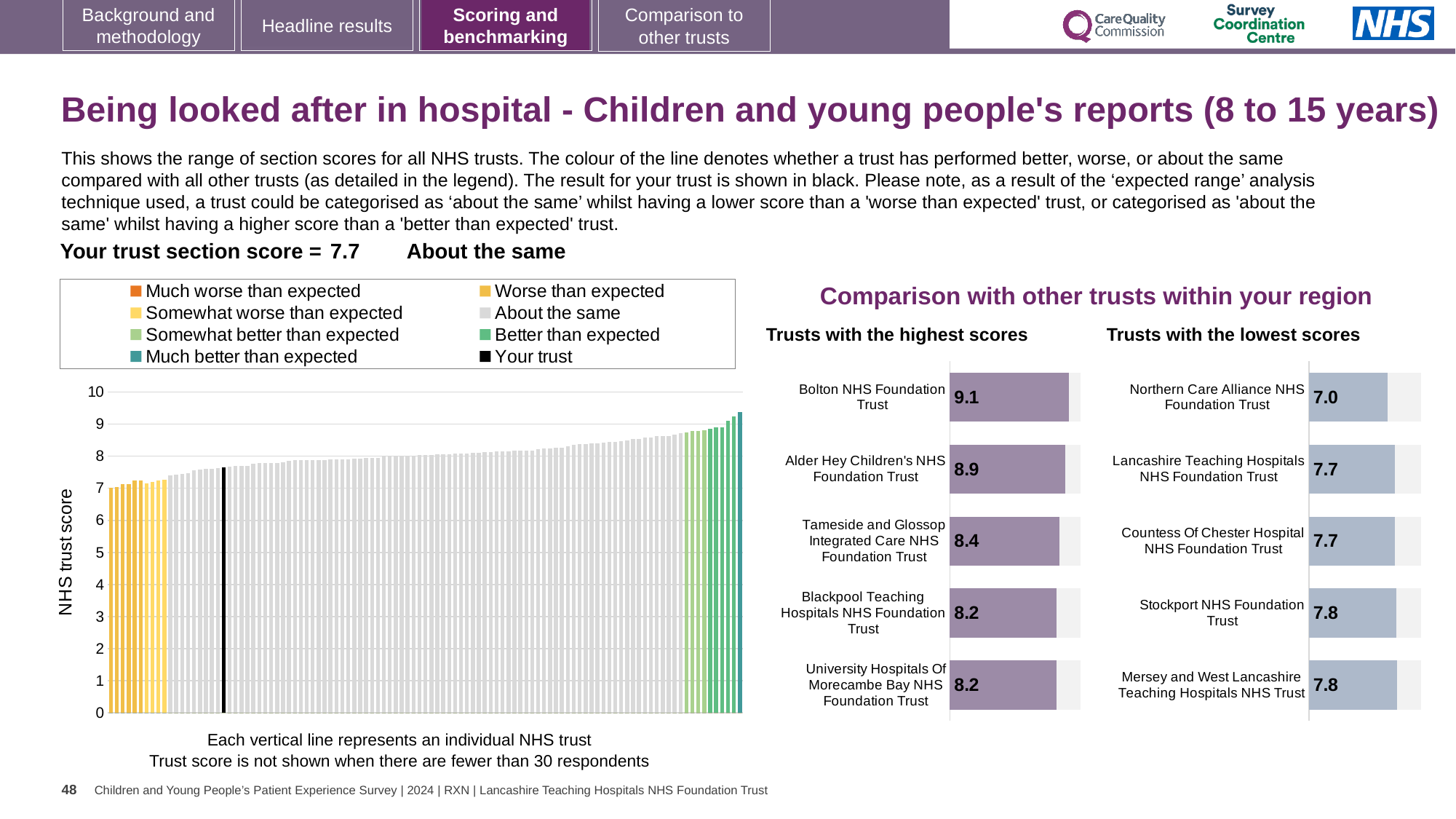
In the main 'NHS trust score' chart on the left, do the bar heights rise or fall from left to right? Rise In the 'Trusts with the lowest scores' chart, which trust has the lowest score? Northern Care Alliance NHS Foundation Trust In the 'Trusts with the highest scores' chart, what is the score for Bolton NHS Foundation Trust? 9.1 In the 'Trusts with the lowest scores' chart, which has the larger score: Northern Care Alliance NHS Foundation Trust or Lancashire Teaching Hospitals NHS Foundation Trust? Lancashire Teaching Hospitals NHS Foundation Trust In the 'Trusts with the lowest scores' chart, what is the score for Northern Care Alliance NHS Foundation Trust? 7.0 In the 'Trusts with the highest scores' chart, which trust has the highest score? Bolton NHS Foundation Trust What kind of chart is the 'Trusts with the lowest scores' chart? Bar chart How many trusts are shown in the 'Trusts with the highest scores' chart? 5 In the 'Trusts with the highest scores' chart, what is the score for Tameside and Glossop Integrated Care NHS Foundation Trust? 8.4 In the 'Trusts with the lowest scores' chart, what is the score for Stockport NHS Foundation Trust? 7.8 How many entries does the legend of the main 'NHS trust score' chart list? 8 In the 'Trusts with the highest scores' chart, what is the difference between the scores of Bolton NHS Foundation Trust and Alder Hey Children's NHS Foundation Trust? 0.2